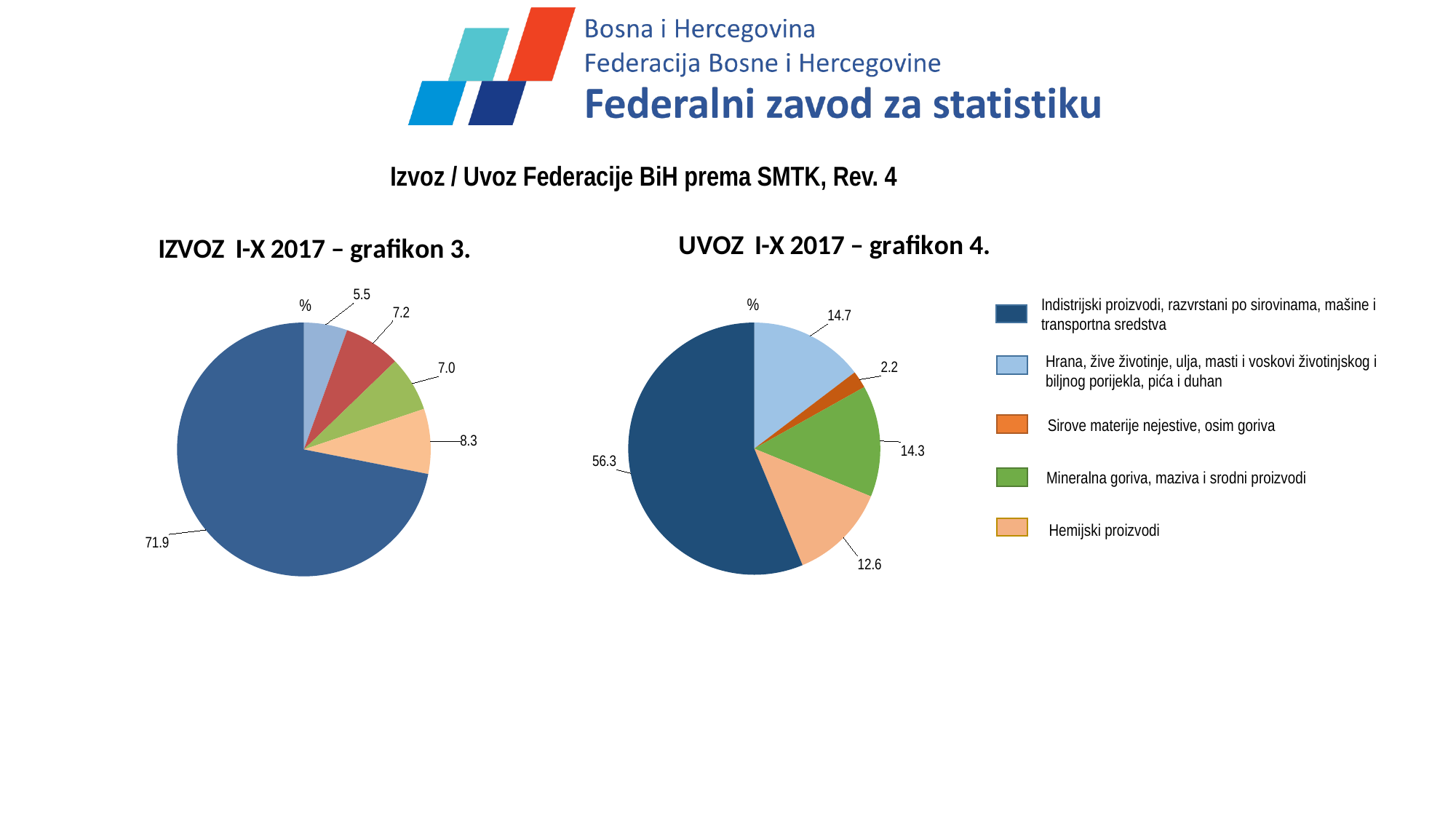
On the IZVOZ I-X 2017 – grafikon 3 chart, what is the value of the largest slice? 71.9 On the UVOZ I-X 2017 – grafikon 4 chart, which category has the largest slice? Indistrijski proizvodi, razvrstani po sirovinama, mašine i transportna sredstva On the UVOZ I-X 2017 – grafikon 4 chart, what is the value for Hemijski proizvodi? 12.6 On the UVOZ I-X 2017 – grafikon 4 chart, what is the difference between the values for Hrana, žive životinje, ulja, masti i voskovi životinjskog i biljnog porijekla, pića i duhan and Mineralna goriva, maziva i srodni proizvodi? 0.4 What type of chart is the UVOZ I-X 2017 – grafikon 4 chart? Pie chart On the UVOZ I-X 2017 – grafikon 4 chart, which is larger: Hemijski proizvodi or Mineralna goriva, maziva i srodni proizvodi? Mineralna goriva, maziva i srodni proizvodi On the IZVOZ I-X 2017 – grafikon 3 chart, what is the difference between the largest and smallest slice values? 66.4 On the UVOZ I-X 2017 – grafikon 4 chart, which category has the smallest slice? Sirove materije nejestive, osim goriva On the UVOZ I-X 2017 – grafikon 4 chart, what is the value for Mineralna goriva, maziva i srodni proizvodi? 14.3 How many slices does the IZVOZ I-X 2017 – grafikon 3 chart have? 5 On the UVOZ I-X 2017 – grafikon 4 chart, what is the value for Sirove materije nejestive, osim goriva? 2.2 On the IZVOZ I-X 2017 – grafikon 3 chart, what is the value of the smallest slice? 5.5